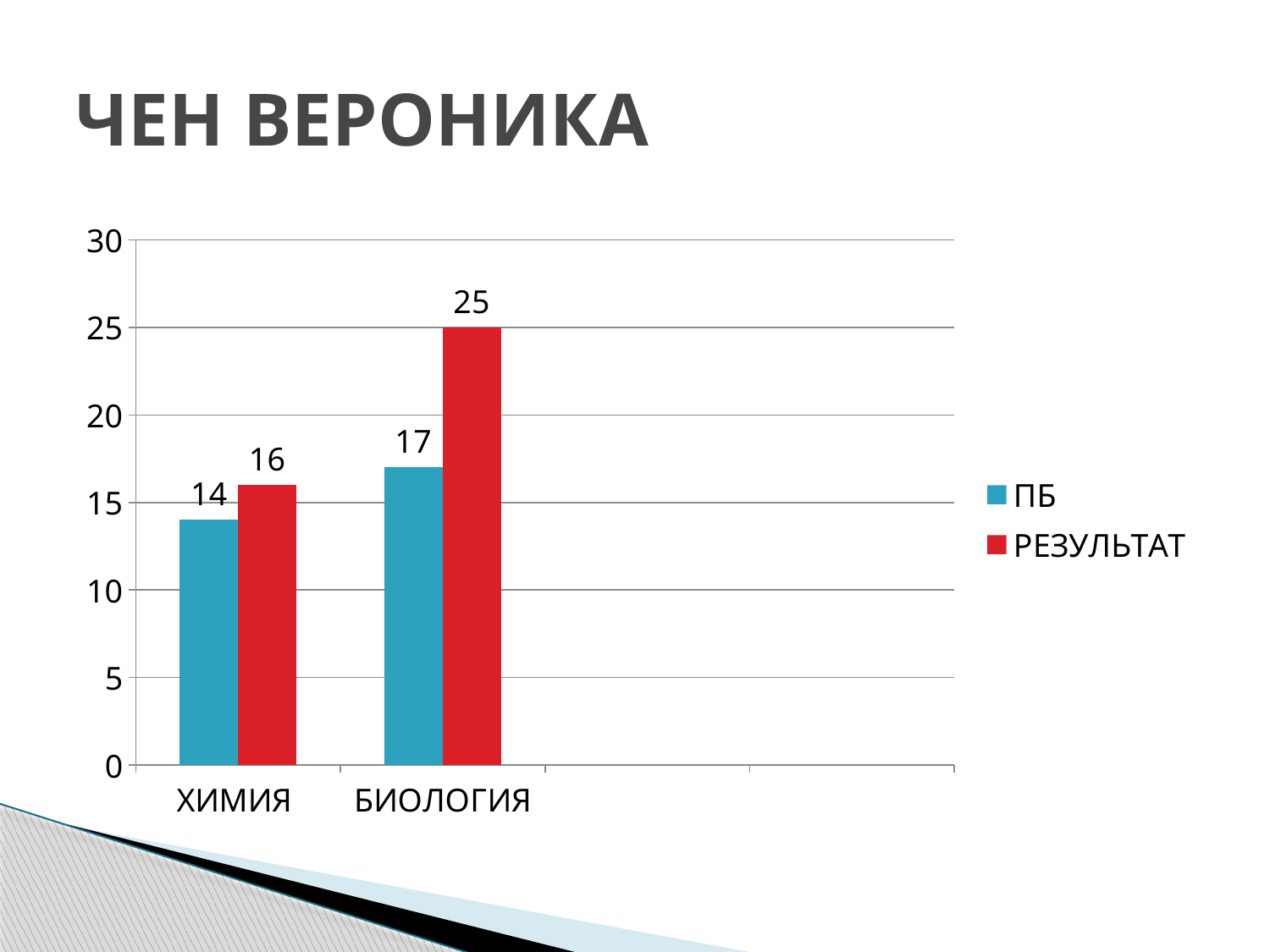
How many categories are shown on the x axis? 2 What is the ПБ value for БИОЛОГИЯ? 17 What is the difference between the РЕЗУЛЬТАТ and ПБ values for БИОЛОГИЯ? 8 What kind of chart is shown on the slide? Bar chart How many series does the legend list? 2 Which category has the highest РЕЗУЛЬТАТ value? БИОЛОГИЯ What is the РЕЗУЛЬТАТ value for ХИМИЯ? 16 What is the ПБ value for ХИМИЯ? 14 What is the difference between the РЕЗУЛЬТАТ values for БИОЛОГИЯ and ХИМИЯ? 9 Which is larger: the ПБ value for БИОЛОГИЯ or the РЕЗУЛЬТАТ value for ХИМИЯ? ПБ value for БИОЛОГИЯ Which category has the lowest ПБ value? ХИМИЯ What is the РЕЗУЛЬТАТ value for БИОЛОГИЯ? 25